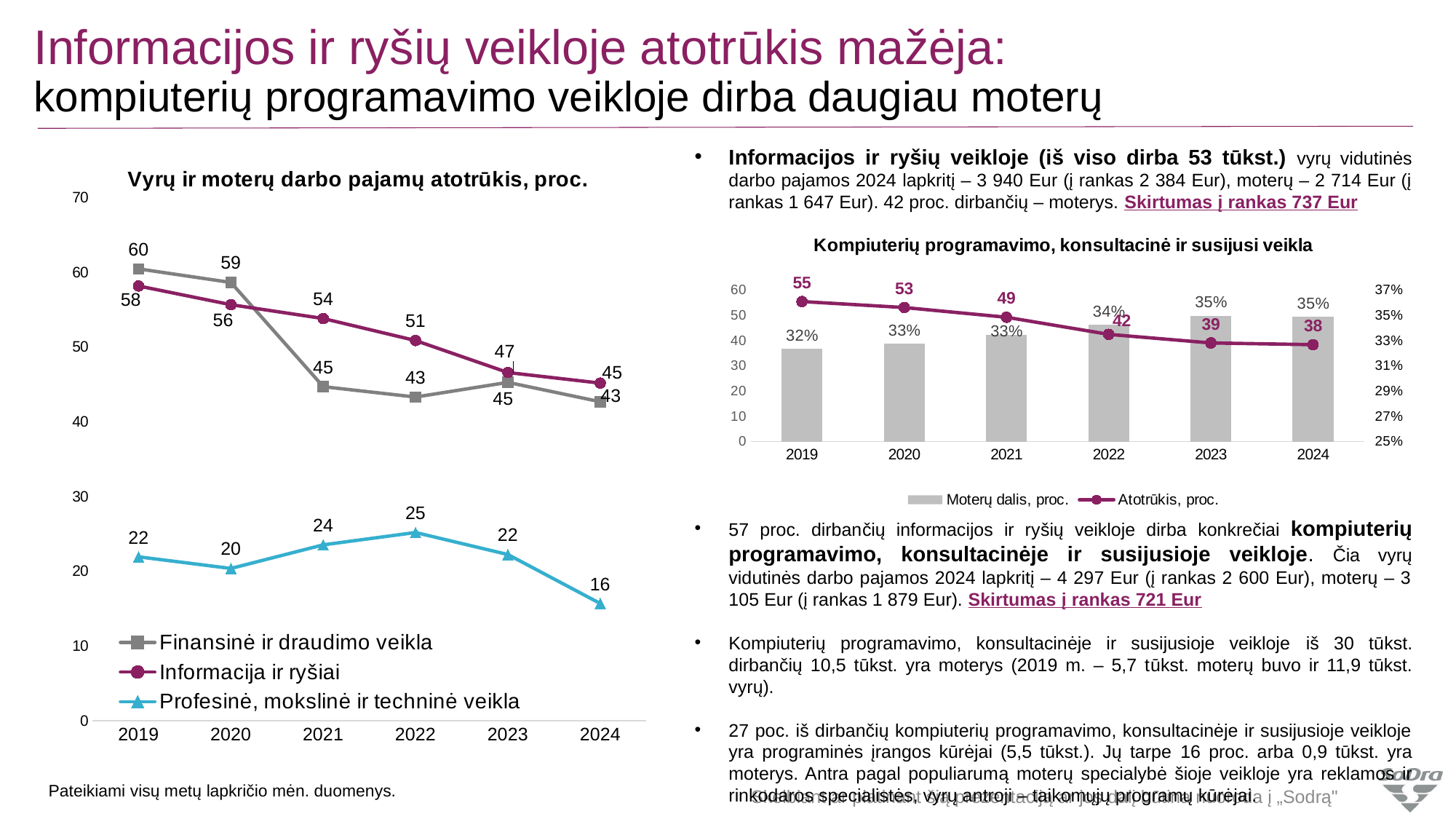
In the chart titled "Vyrų ir moterų darbo pajamų atotrūkis, proc.", in which year is the value for Profesinė, mokslinė ir techninė veikla lowest? 2024 In the chart titled "Vyrų ir moterų darbo pajamų atotrūkis, proc.", how many series does the legend list? 3 In the chart titled "Kompiuterių programavimo, konsultacinė ir susijusi veikla", how many years are shown on the x axis? 6 In the chart titled "Vyrų ir moterų darbo pajamų atotrūkis, proc.", which series has the larger value in 2021: Finansinė ir draudimo veikla or Informacija ir ryšiai? Informacija ir ryšiai In the chart titled "Vyrų ir moterų darbo pajamų atotrūkis, proc.", what is the value for Informacija ir ryšiai in 2024? 45 In the chart titled "Kompiuterių programavimo, konsultacinė ir susijusi veikla", what is the Atotrūkis, proc. value for 2022? 42 In the chart titled "Vyrų ir moterų darbo pajamų atotrūkis, proc.", does the Informacija ir ryšiai series rise or fall from 2019 to 2024? fall In the chart titled "Vyrų ir moterų darbo pajamų atotrūkis, proc.", what is the difference between the Informacija ir ryšiai values in 2019 and 2024? 13 In the chart titled "Kompiuterių programavimo, konsultacinė ir susijusi veikla", what is the difference between the Atotrūkis, proc. values in 2019 and 2024? 17 In the chart titled "Kompiuterių programavimo, konsultacinė ir susijusi veikla", what is the Moterų dalis, proc. value for 2019? 32% In the chart titled "Vyrų ir moterų darbo pajamų atotrūkis, proc.", in which year is the value for Profesinė, mokslinė ir techninė veikla highest? 2022 In the chart titled "Vyrų ir moterų darbo pajamų atotrūkis, proc.", what is the value for Finansinė ir draudimo veikla in 2019? 60